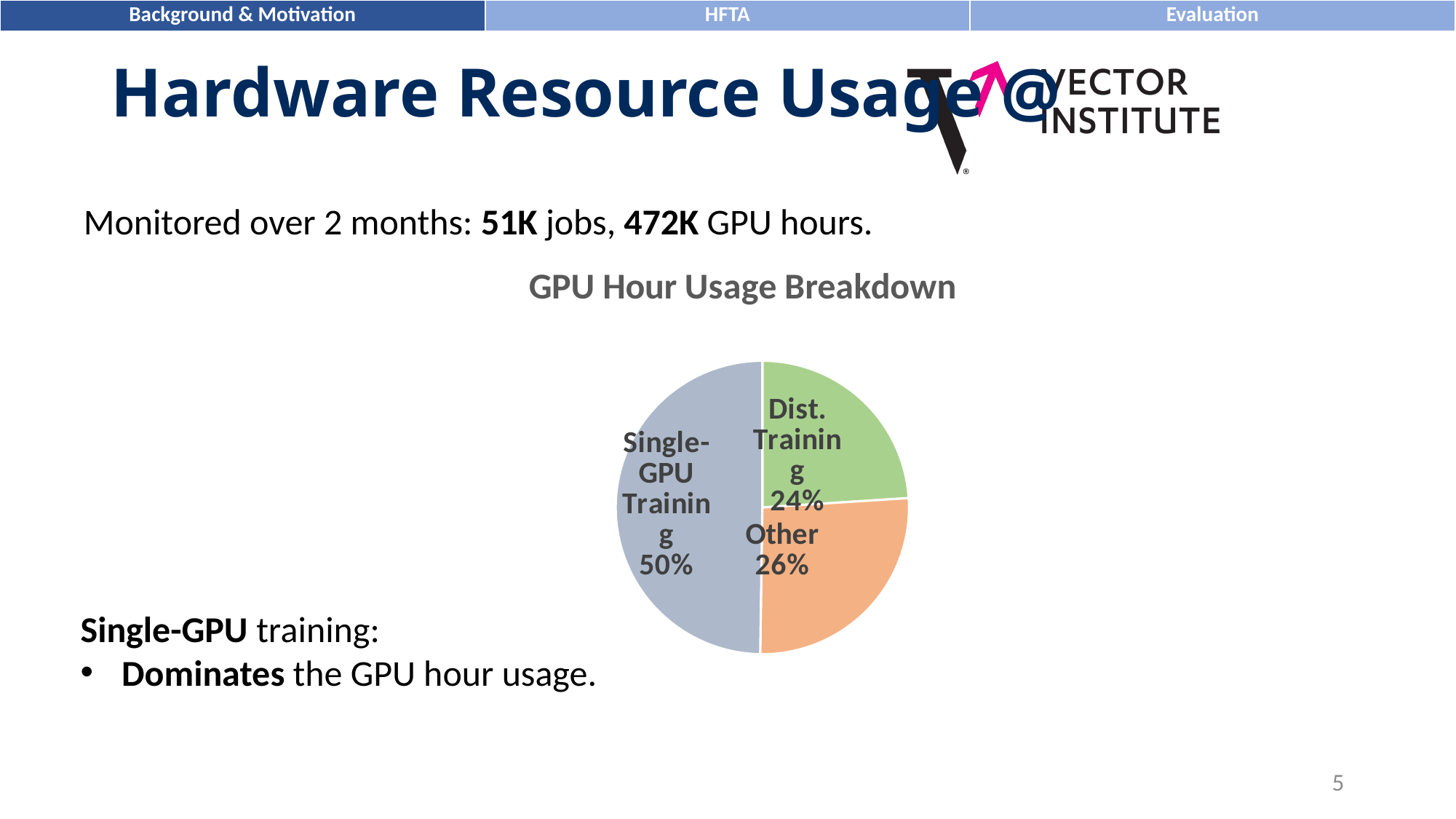
Which slice of the pie is the smallest? Dist. Training What is the difference in percentage points between Other and Dist. Training? 2 How many slices does the pie chart have? 3 What is the title of the chart? GPU Hour Usage Breakdown What share of GPU hours does Dist. Training account for? 24% Which slice of the pie is the largest? Single-GPU Training What is the difference in percentage points between Single-GPU Training and Other? 24 What share of GPU hours does Single-GPU Training account for? 50% What colour is the Single-GPU Training slice? grey-blue What share of GPU hours does Other account for? 26% Which is larger, the share for Single-GPU Training or the share for Dist. Training? Single-GPU Training What kind of chart is shown on the slide? pie chart